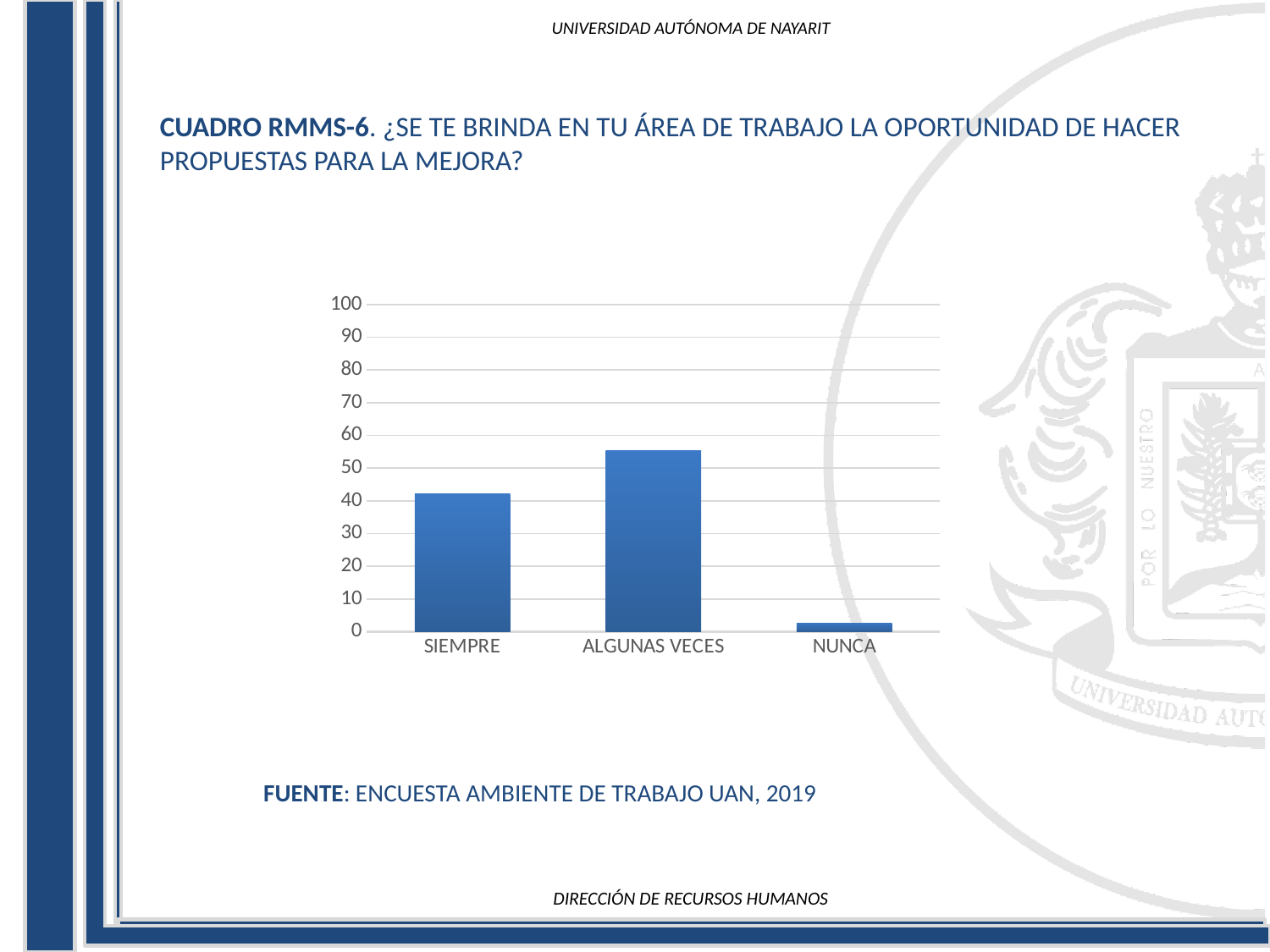
Is the value for SIEMPRE greater or less than 50? less Is the value for SIEMPRE greater or less than 30? greater What kind of chart is shown on the slide? bar chart Which is larger, the value for SIEMPRE or the value for ALGUNAS VECES? ALGUNAS VECES Is the value for ALGUNAS VECES greater or less than 50? greater What source is cited below the chart? ENCUESTA AMBIENTE DE TRABAJO UAN, 2019 Which is larger, the value for SIEMPRE or the value for NUNCA? SIEMPRE How many categories are shown on the x axis of the chart? 3 Which category has the highest bar in the chart? ALGUNAS VECES What is the maximum value shown on the y axis of the chart? 100 Which category has the lowest bar in the chart? NUNCA